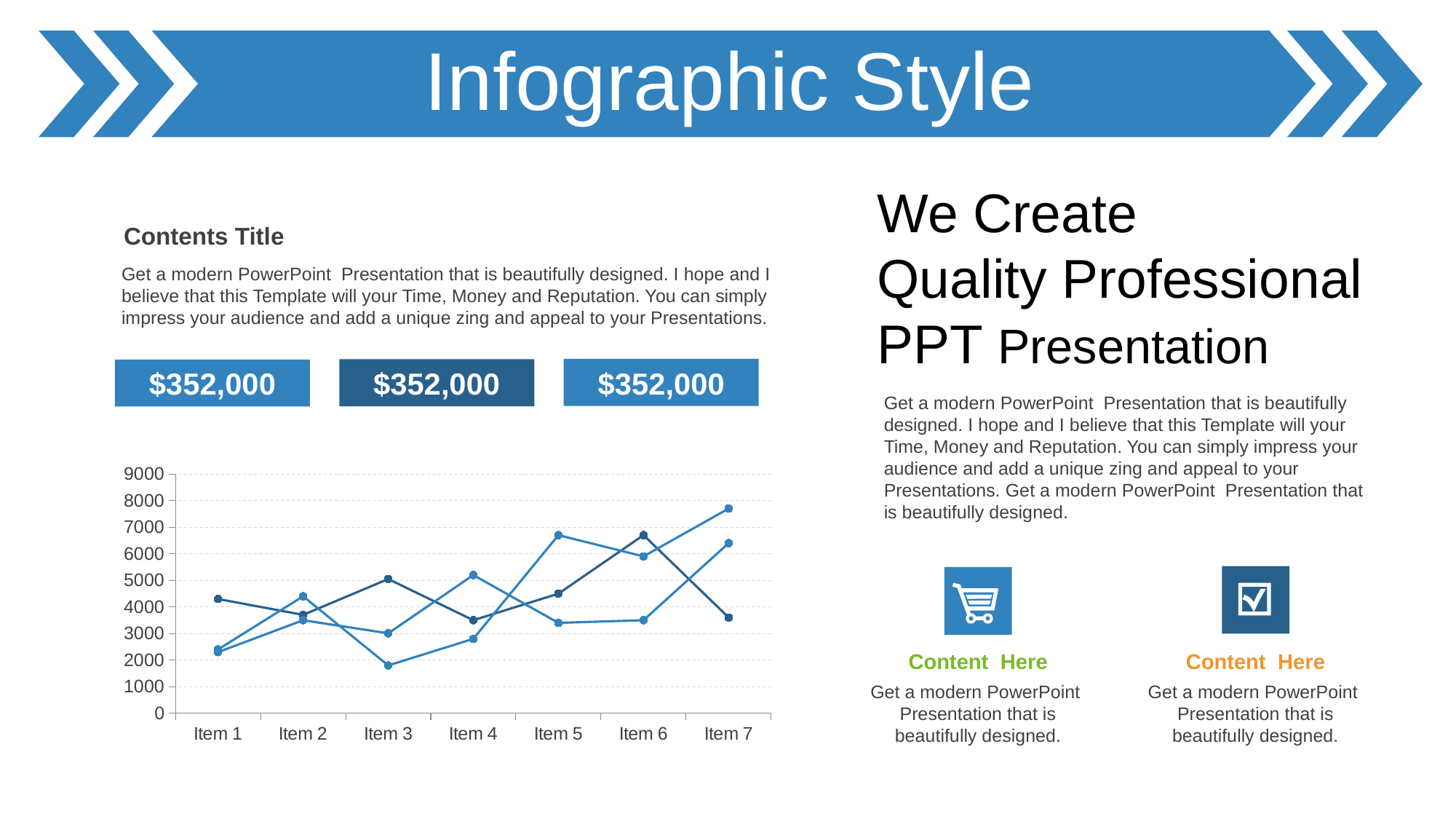
At which category does the dark blue line reach its highest value? Item 6 At which category does the lowest point on the whole chart occur? Item 3 For the dark blue line, which is larger: the value at Item 6 or the value at Item 7? Item 6 At which category does the highest point on the whole chart occur? Item 7 What is the label of the first category on the x axis? Item 1 How many categories are shown on the x axis of the chart? 7 Is the value of the dark blue line at Item 3 greater or less than 4000? greater Is the value of the dark blue line at Item 7 greater or less than 4000? less Is the value of the dark blue line at Item 6 greater or less than 6000? greater What kind of chart is shown on the slide? line chart How many lines are plotted on the chart? 3 What is the highest value shown on the chart's y axis? 9000